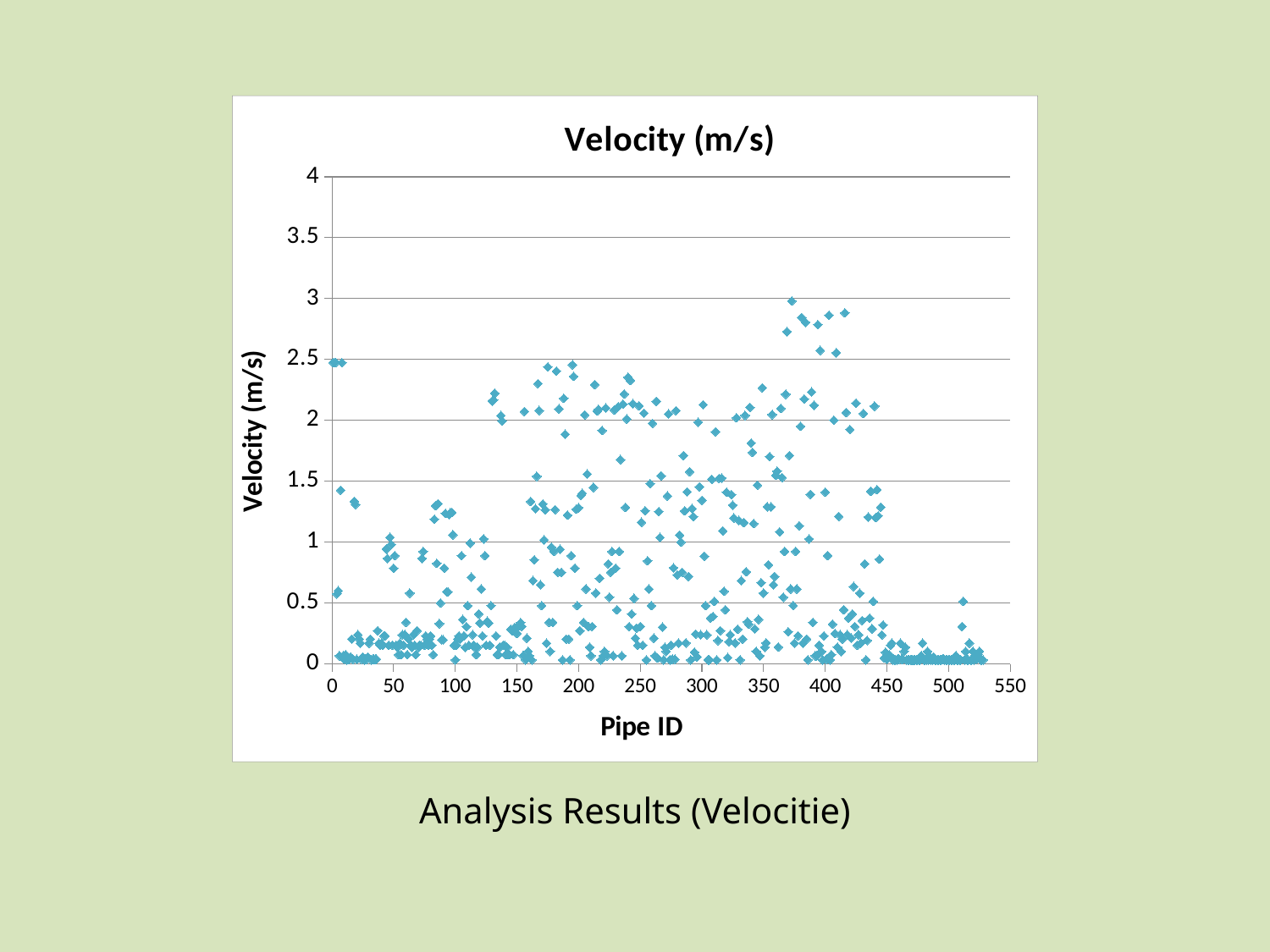
What is the label of the x axis? Pipe ID Is the highest velocity plotted on the chart greater or less than 2.5? greater Is the highest velocity for pipe IDs between 150 and 250 greater or less than 3? less What is the title of the chart? Velocity (m/s) Is the highest velocity for pipe IDs between 50 and 100 greater or less than 2? less What kind of chart is shown on the slide? scatter plot